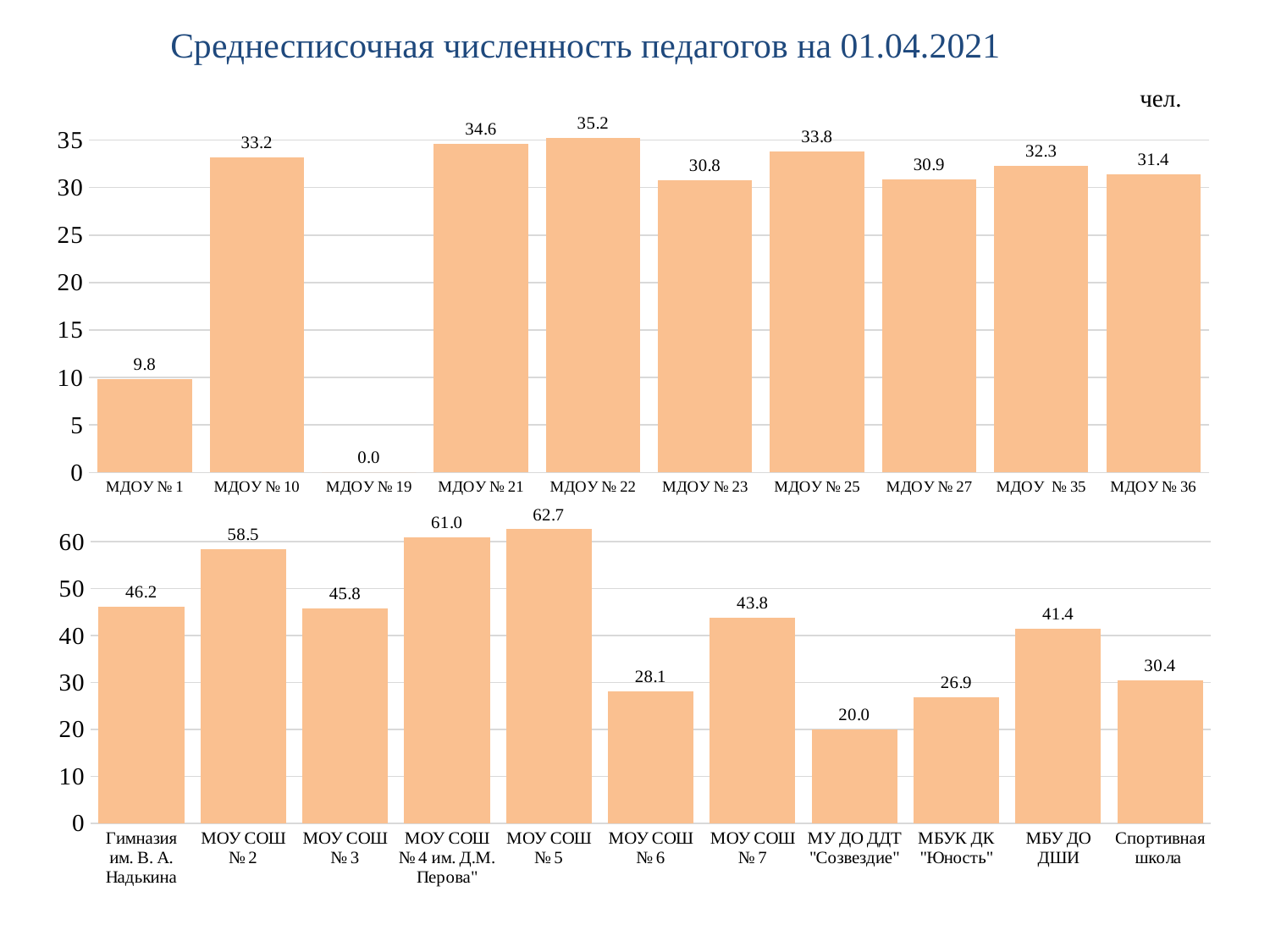
What kind of chart is the bottom chart? Bar chart In the top chart, what is the value for МДОУ № 22? 35.2 In the top chart, what is the value for МДОУ № 1? 9.8 In the bottom chart, what is the value for МОУ СОШ № 5? 62.7 In the bottom chart, how many categories are shown on the x axis? 11 In the bottom chart, what is the value for МУ ДО ДДТ "Созвездие"? 20.0 In the top chart, how many categories are shown on the x axis? 10 In the bottom chart, which is larger: the value for МОУ СОШ № 2 or the value for МОУ СОШ № 7? МОУ СОШ № 2 In the top chart, which category has the highest value? МДОУ № 22 In the bottom chart, which category has the lowest value? МУ ДО ДДТ "Созвездие" In the top chart, what is the difference between the values for МДОУ № 10 and МДОУ № 1? 23.4 In the top chart, which category has the lowest value? МДОУ № 19